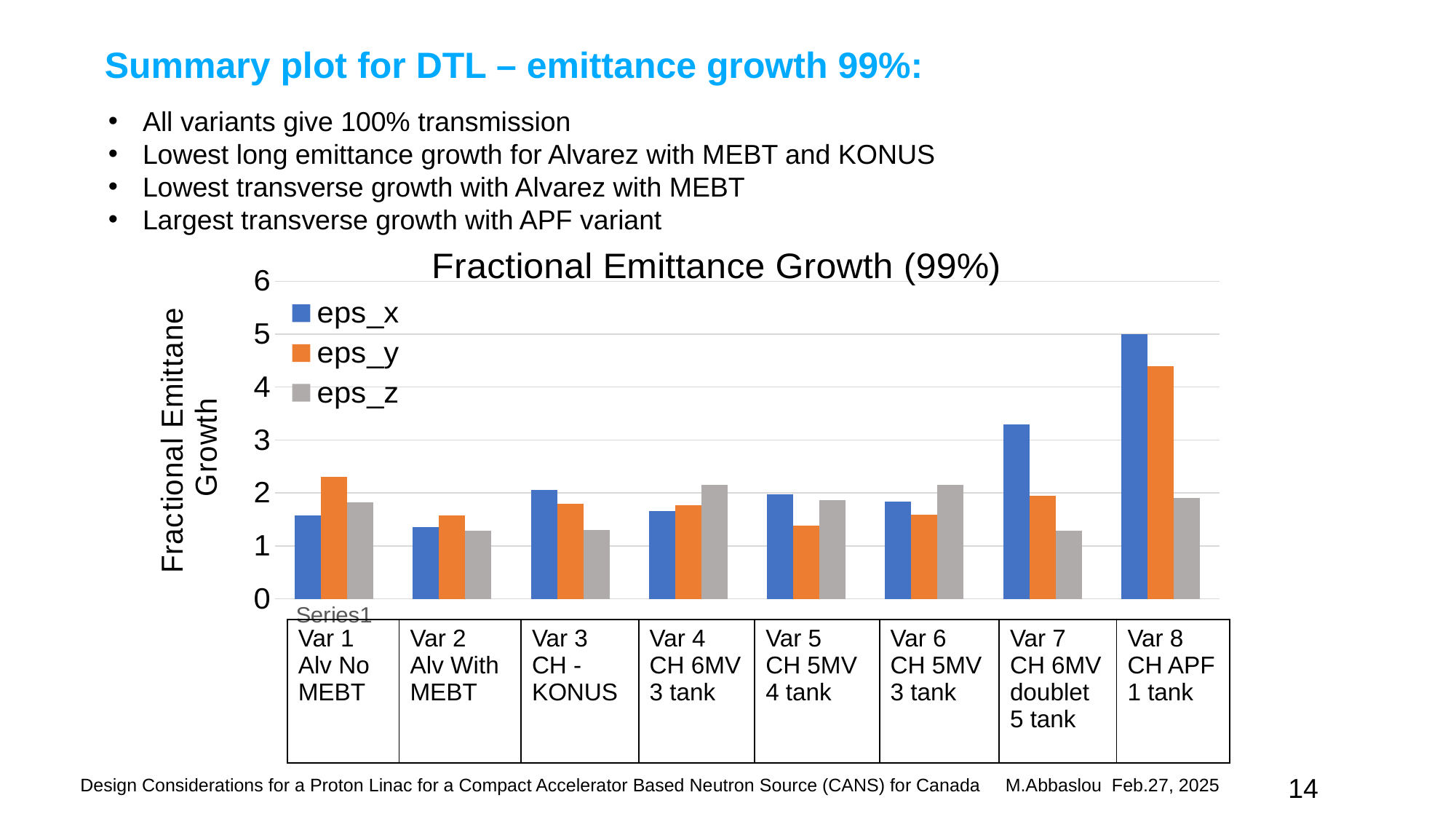
What kind of chart is shown on the slide? bar chart Is the eps_y value for Var 1 Alv No MEBT greater or less than 2? greater What is the title of the chart? Fractional Emittance Growth (99%) For Var 1 Alv No MEBT, which is larger, eps_x or eps_y? eps_y Is the eps_x value for Var 8 CH APF 1 tank greater or less than 4? greater Which variant has the highest eps_y value? Var 8 CH APF 1 tank Which variant has the lowest eps_x value? Var 2 Alv With MEBT How many series does the chart legend list? 3 Which colour represents the eps_y series in the chart? orange Which variant has the highest eps_x value? Var 8 CH APF 1 tank Is the eps_x value for Var 7 CH 6MV doublet 5 tank greater or less than 3? greater How many variant categories are plotted along the x axis? 8